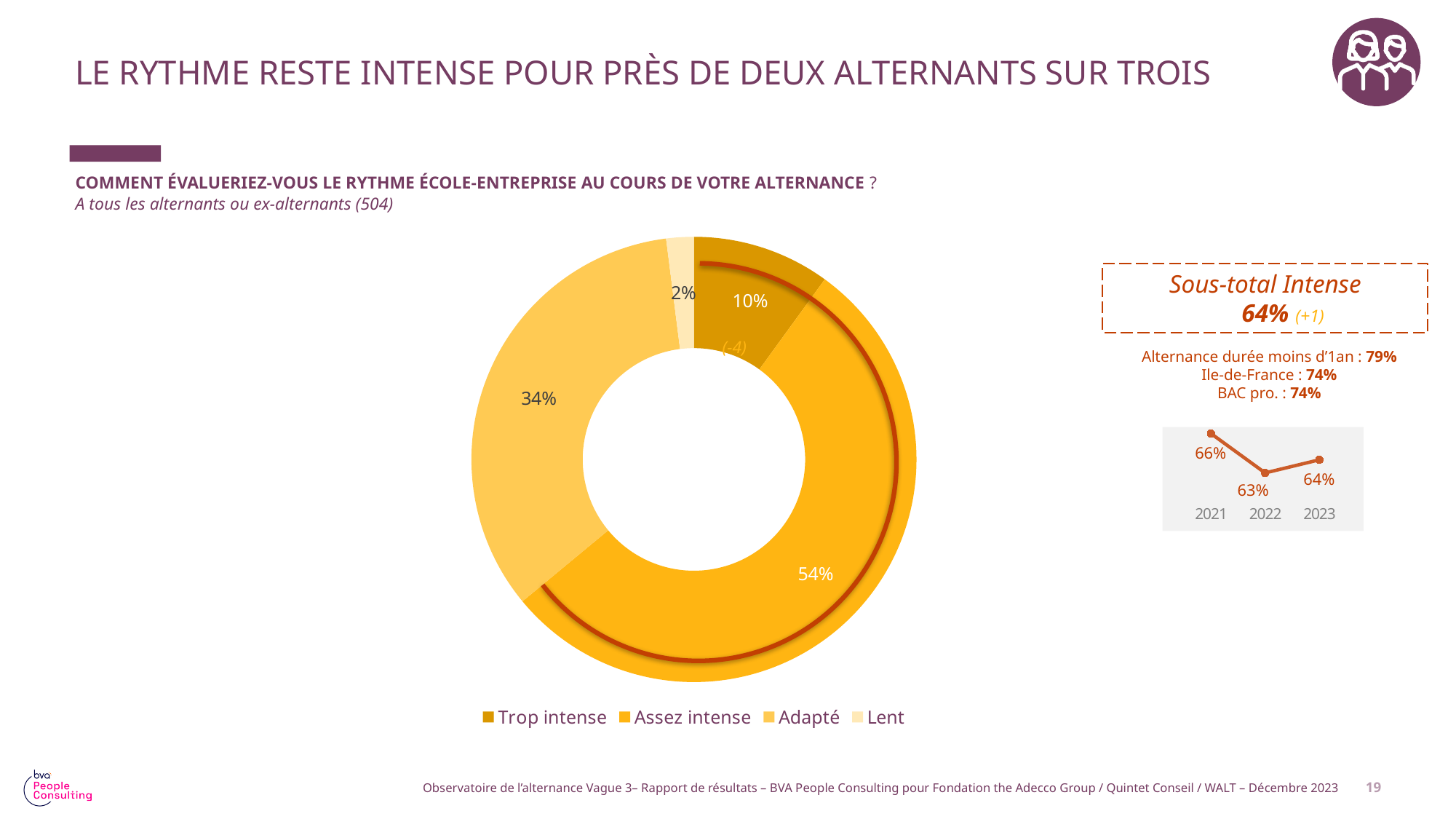
In the donut chart, what share of respondents answered "Adapté"? 34% In the donut chart, which category has the largest share? Assez intense What type of chart is the main chart on the slide? Donut (pie) chart In the donut chart, what is the difference in percentage points between "Assez intense" and "Adapté"? 20 In the donut chart, what share of respondents answered "Trop intense"? 10% How many categories does the legend of the donut chart list? 4 In the small line chart on the right, which year has the highest value? 2021 In the small line chart on the right, what is the value for 2022? 63% In the donut chart, what share of respondents answered "Assez intense"? 54% In the small line chart on the right, how many data points are plotted? 3 In the donut chart, which category has the smallest share? Lent In the donut chart, which is larger: the share for "Trop intense" or the share for "Lent"? Trop intense